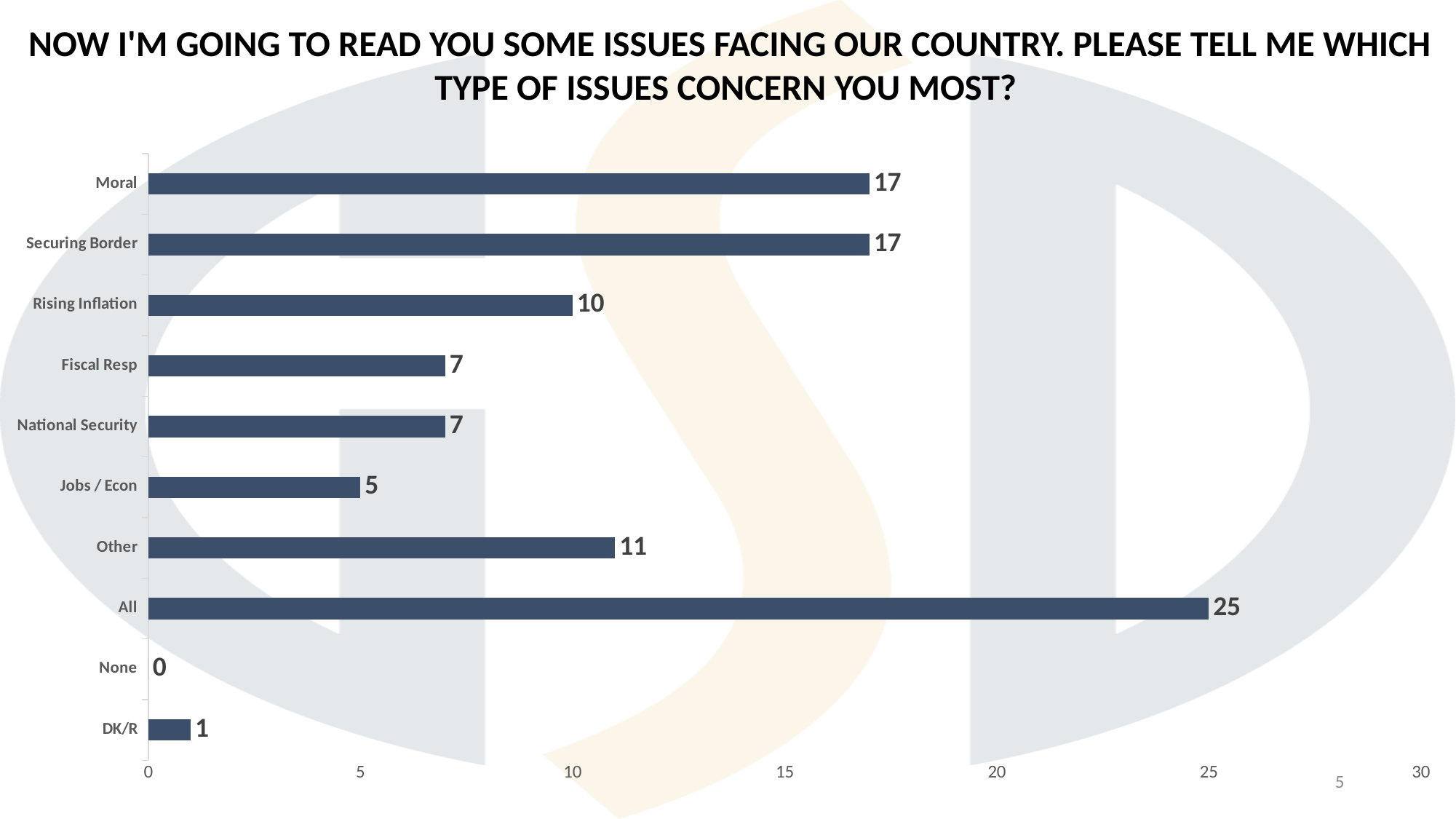
What is the value for All? 25 How many categories are shown on the chart? 10 What is the difference between the values for Moral and Rising Inflation? 7 What is the value for Jobs / Econ? 5 What is the value for Rising Inflation? 10 Which is larger, the value for Other or the value for Fiscal Resp? Other What is the value for Securing Border? 17 Which category has the lowest value? None What is the value for DK/R? 1 What is the difference between the values for All and Other? 14 What kind of chart is shown on the slide? Bar chart Which category has the highest value? All